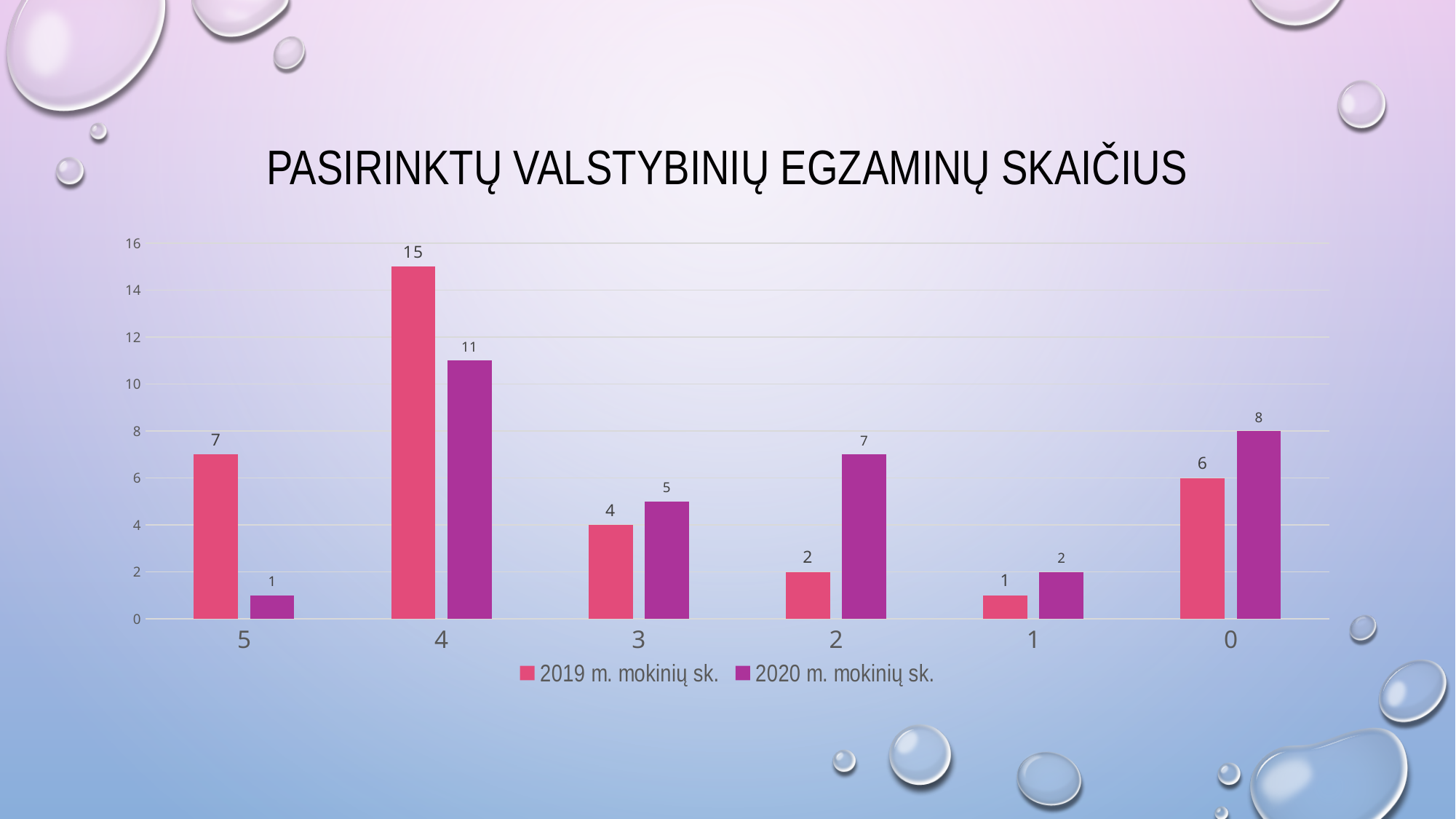
How many categories are shown on the x axis? 6 What is the value for 2020 m. mokinių sk. at category 5? 1 What is the value for 2020 m. mokinių sk. at category 0? 8 Which category has the lowest value for 2020 m. mokinių sk.? 5 Which is larger at category 2: 2019 m. mokinių sk. or 2020 m. mokinių sk.? 2020 m. mokinių sk. What is the difference between the 2020 m. mokinių sk. values at category 0 and category 1? 6 Which category has the highest value for 2019 m. mokinių sk.? 4 What is the title of the chart? Pasirinktų valstybinių egzaminų skaičius What is the difference between the 2019 m. mokinių sk. and 2020 m. mokinių sk. values at category 4? 4 What is the value for 2019 m. mokinių sk. at category 4? 15 What kind of chart is shown on the slide? bar chart How many series does the legend list? 2